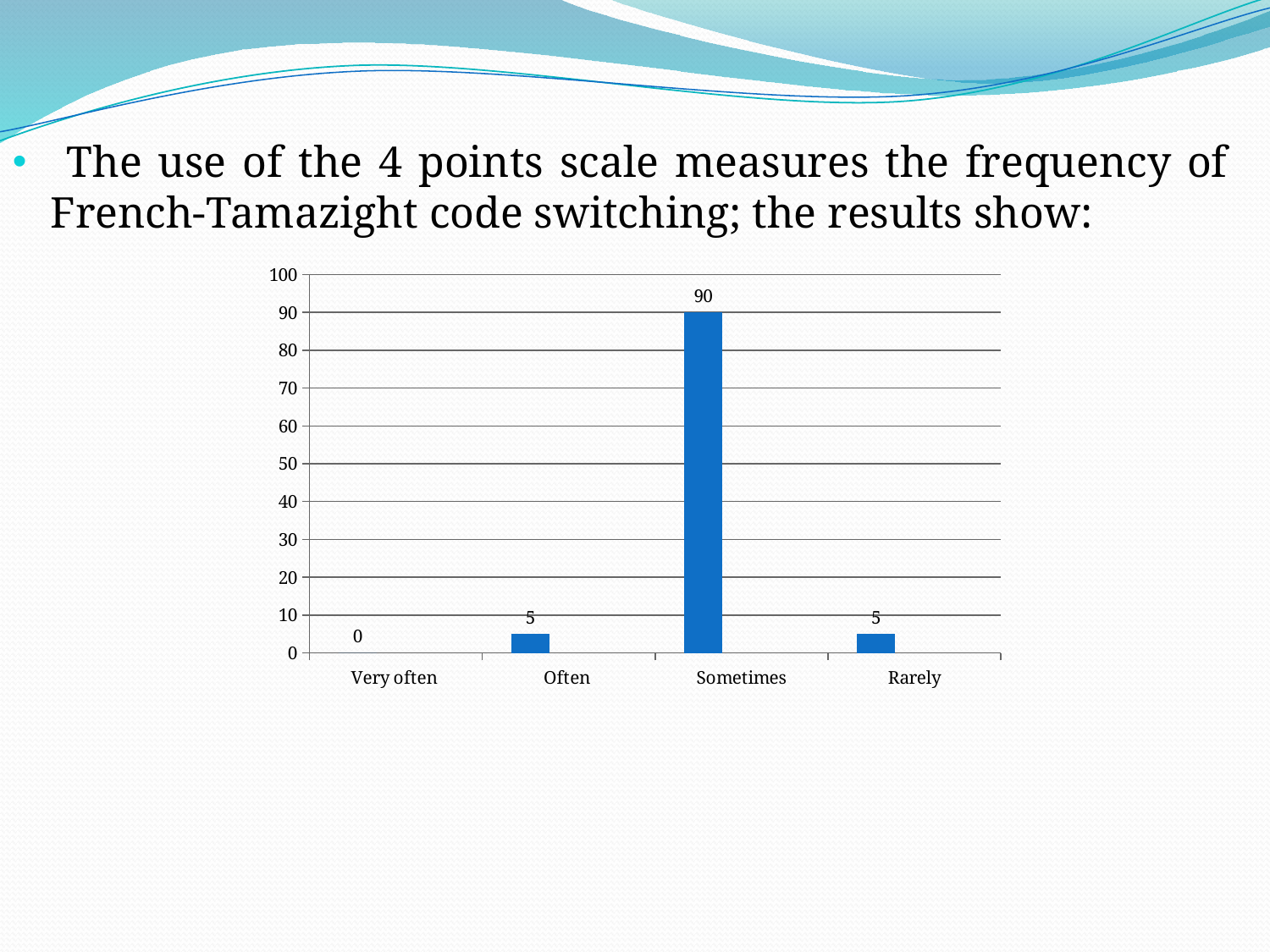
Which category has the highest value? Sometimes What is the value for Sometimes? 90 What kind of chart is shown on the slide? bar chart Which is larger, the value for Sometimes or the value for Rarely? Sometimes What is the difference between the values for Sometimes and Often? 85 Is the value for Sometimes greater or less than 50? greater What is the highest value shown on the y axis? 100 What is the value for Often? 5 What is the value for Very often? 0 How many categories are shown on the x axis? 4 What is the value for Rarely? 5 Which category has the lowest value? Very often